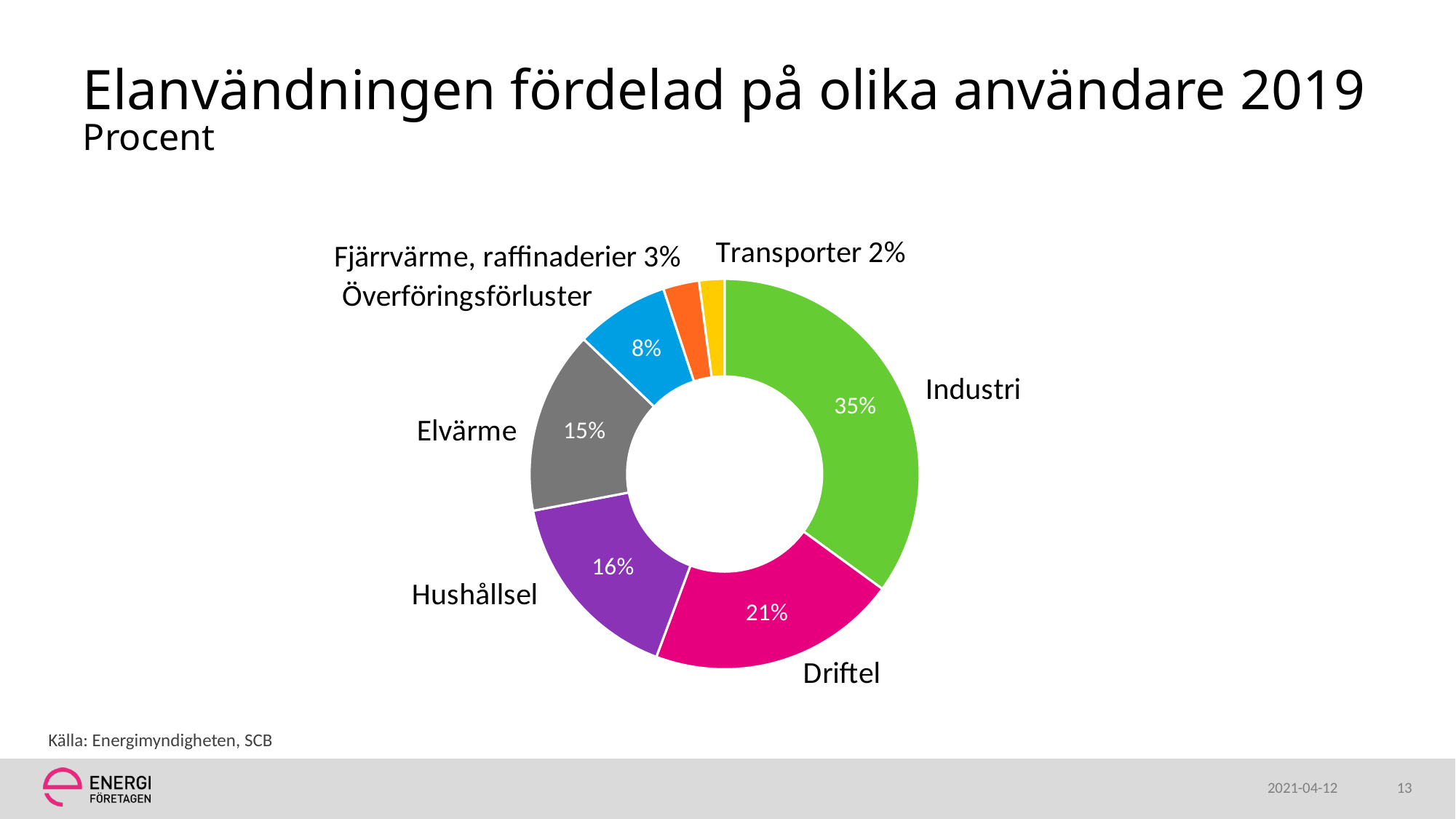
Which category has the smallest share of the chart? Transporter What is the difference in percentage points between Industri and Driftel? 14 What share of the donut chart does Industri account for? 35% How many categories are shown in the chart? 7 Which is larger, Hushållsel or Elvärme? Hushållsel What is the value for Elvärme? 15% What is the value for Transporter? 2% What type of chart is shown on the slide? Donut (pie) chart Which category has the largest share of the chart? Industri What is the value shown for Driftel? 21% What percentage is shown for Överföringsförluster? 8% What percentage is shown for Hushållsel? 16%